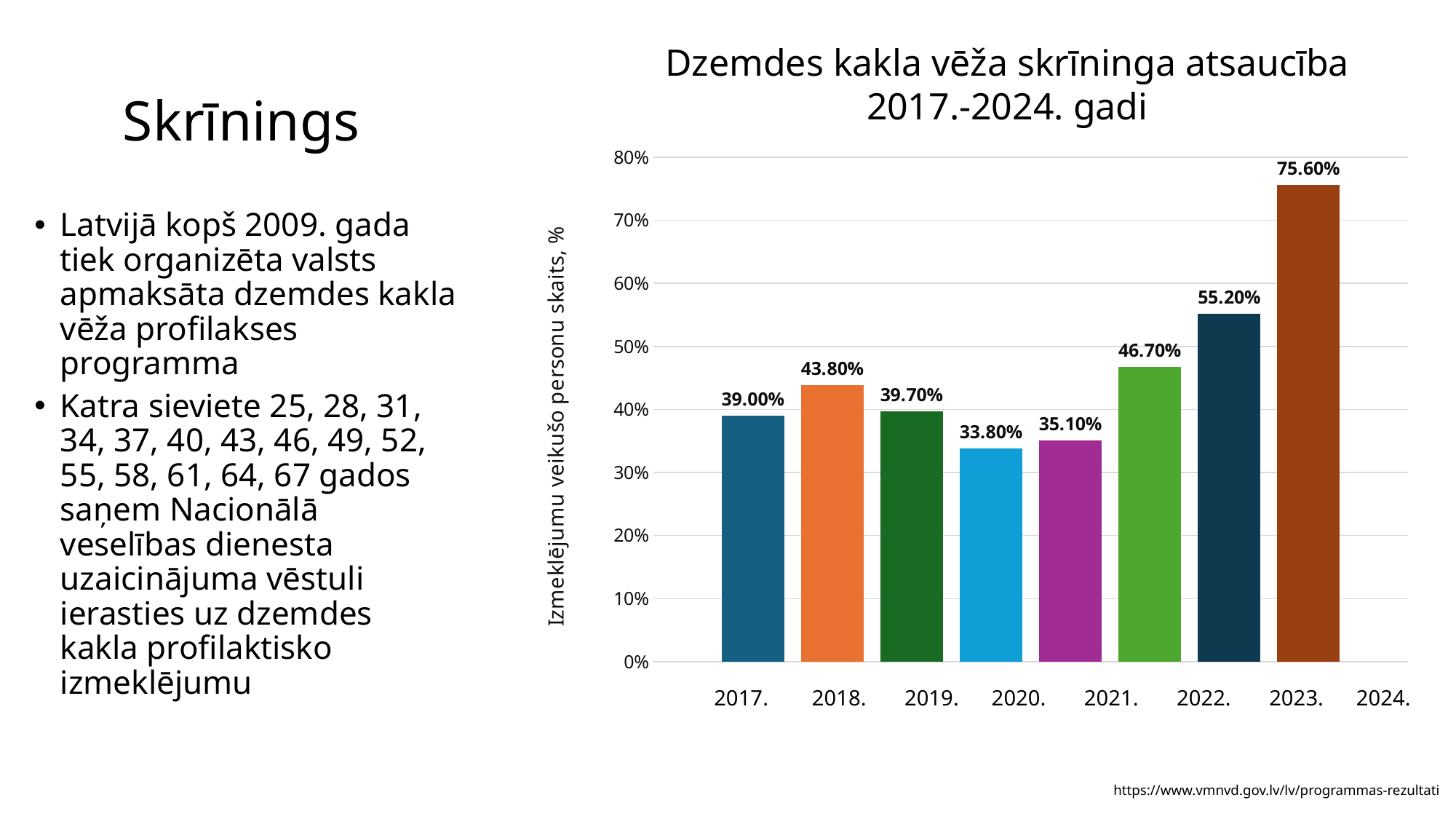
Do the values of the last three bars rise or fall from left to right? rise Is the value of the tallest bar greater or less than 70%? greater What kind of chart is shown on the slide? bar chart What is the difference between the value for 2017 (39.00%) and the second bar (43.80%)? 4.80% What is the value of the shortest bar in the chart? 33.80% How many bars are plotted in the chart? 8 What is the value of the tallest bar in the chart? 75.60% What is the value shown for 2017? 39.00% What is the title of the chart? Dzemdes kakla vēža skrīninga atsaucība 2017.-2024. gadi What is the difference between the highest and lowest values in the chart? 41.80% What is the label of the vertical axis? Izmeklējumu veikušo personu skaits, % Which is larger, the value for 2017 or the value of the shortest bar (33.80%)? 2017